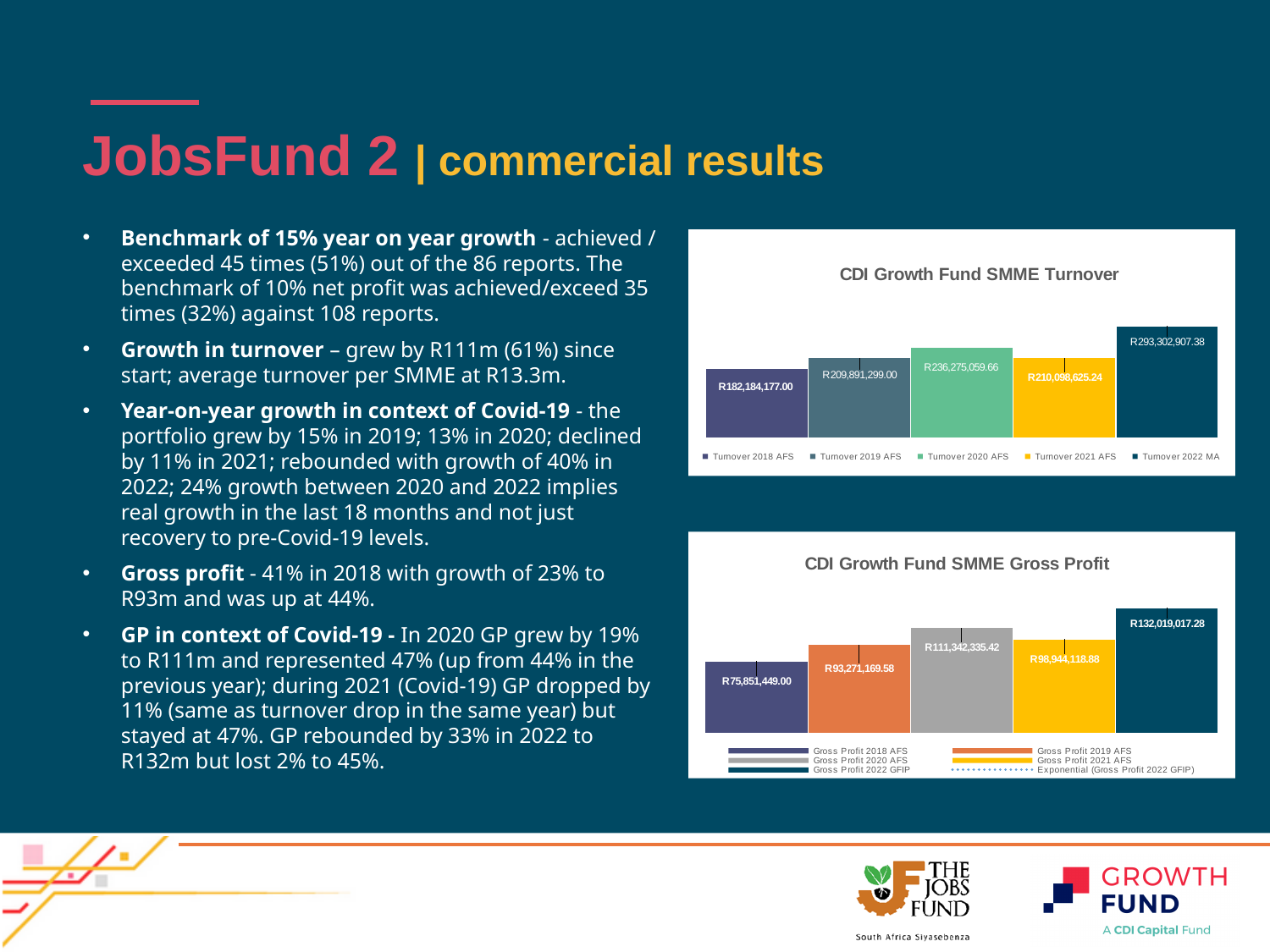
In the CDI Growth Fund SMME Turnover chart, what is the value for Turnover 2018 AFS? R182,184,177.00 In the CDI Growth Fund SMME Gross Profit chart, what is the value for Gross Profit 2019 AFS? R93,271,169.58 In the CDI Growth Fund SMME Gross Profit chart, which series has the lowest value? Gross Profit 2018 AFS In the CDI Growth Fund SMME Gross Profit chart, what is the difference between Gross Profit 2022 GFIP and Gross Profit 2021 AFS? R33,074,898.40 In the CDI Growth Fund SMME Turnover chart, what is the value for Turnover 2020 AFS? R236,275,059.66 In the CDI Growth Fund SMME Turnover chart, which series has the lowest value? Turnover 2018 AFS What kind of chart is the CDI Growth Fund SMME Gross Profit chart? Bar chart In the CDI Growth Fund SMME Gross Profit chart, what is the value for Gross Profit 2022 GFIP? R132,019,017.28 In the CDI Growth Fund SMME Turnover chart, how many series does the legend list? 5 In the CDI Growth Fund SMME Gross Profit chart, which is larger: Gross Profit 2020 AFS or Gross Profit 2021 AFS? Gross Profit 2020 AFS In the CDI Growth Fund SMME Turnover chart, which series has the highest value? Turnover 2022 MA In the CDI Growth Fund SMME Turnover chart, what is the difference between Turnover 2022 MA and Turnover 2018 AFS? R111,118,730.38